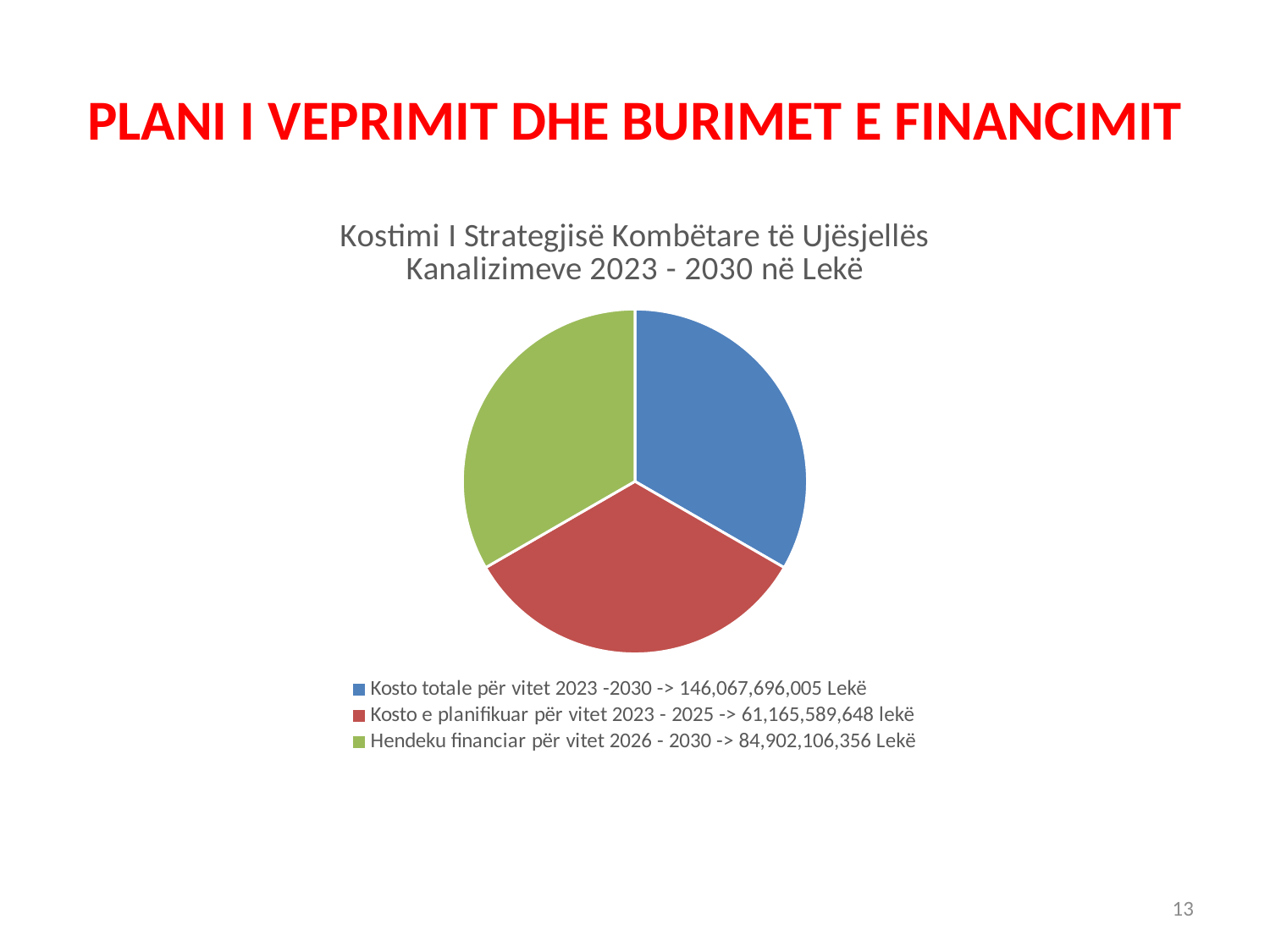
Based on the values printed in the legend, which is larger: 'Kosto e planifikuar për vitet 2023 - 2025' or 'Hendeku financiar për vitet 2026 - 2030'? Hendeku financiar për vitet 2026 - 2030 What kind of chart is shown on the slide? pie chart According to the legend, what is the value for 'Hendeku financiar për vitet 2026 - 2030'? 84,902,106,356 Lekë According to the legend, what is the value for 'Kosto e planifikuar për vitet 2023 - 2025'? 61,165,589,648 lekë According to the legend, what is the value for 'Kosto totale për vitet 2023 -2030'? 146,067,696,005 Lekë Which colour represents 'Hendeku financiar për vitet 2026 - 2030' in the pie chart? green Based on the values printed in the legend, which entry has the smallest value? Kosto e planifikuar për vitet 2023 - 2025 How many slices does the pie chart have? 3 How many entries does the legend list? 3 What is the title of the chart? Kostimi I Strategjisë Kombëtare të Ujësjellës Kanalizimeve 2023 - 2030 në Lekë Based on the values printed in the legend, which entry has the largest value? Kosto totale për vitet 2023 -2030